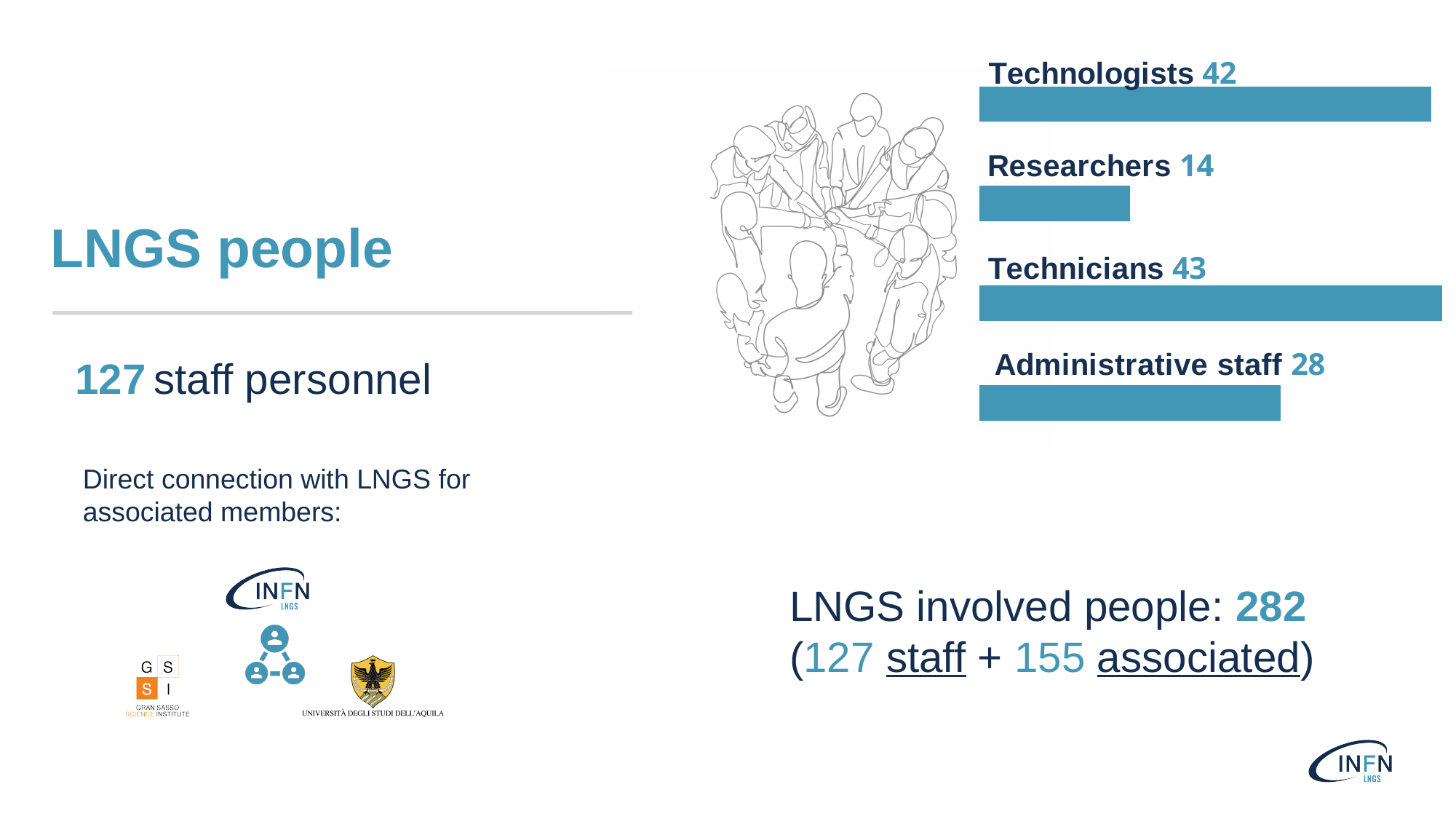
What kind of chart is shown on the slide? bar chart What is the difference between the Administrative staff and Researchers values? 14 What is the difference between the Technicians and Researchers values? 29 How many categories does the bar chart show? 4 Which is larger, Administrative staff or Researchers? Administrative staff What is the value for Researchers in the bar chart? 14 What is the total of the four staff categories in the bar chart? 127 How many Technologists are shown in the bar chart? 42 What is the value for Administrative staff in the bar chart? 28 What is the value for Technicians in the bar chart? 43 Which category has the lowest value in the bar chart? Researchers Which category has the highest value in the bar chart? Technicians